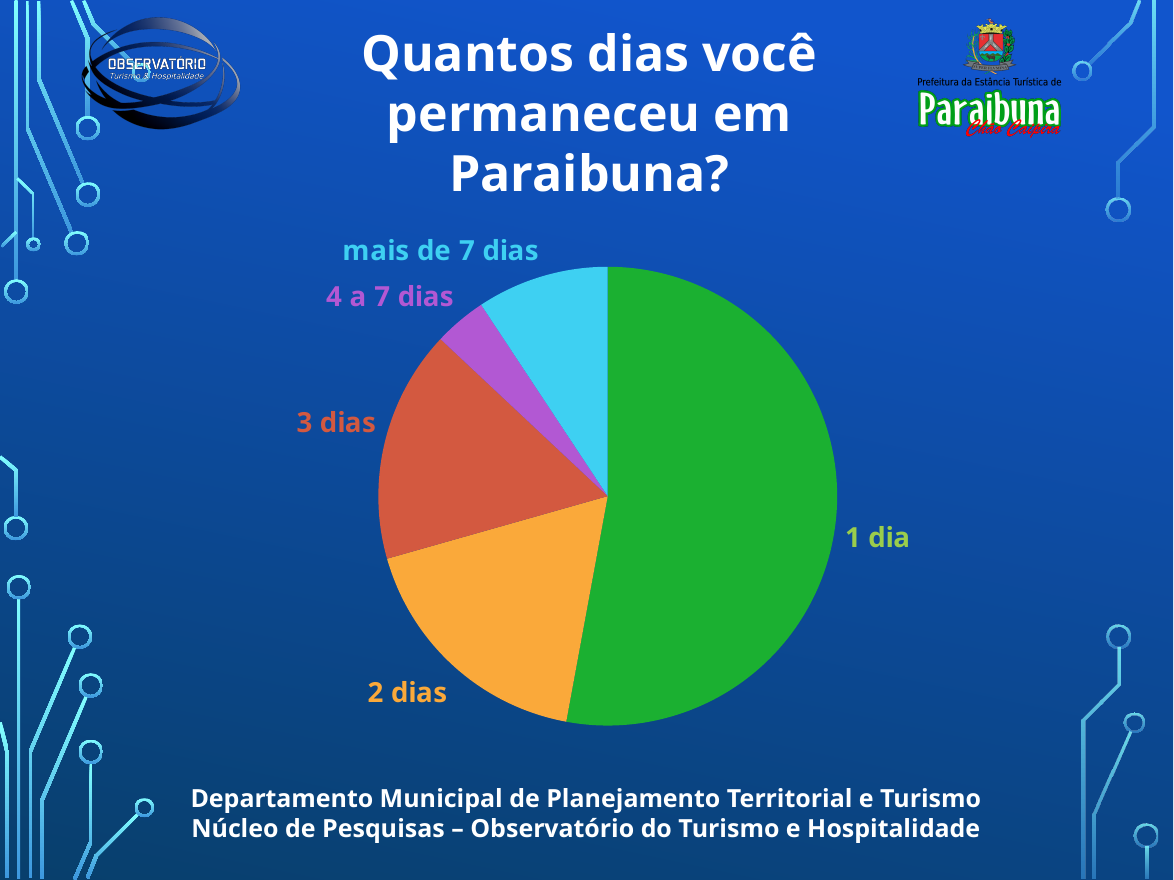
How many categories (slices) does the pie chart have? 5 Which category has the largest slice of the pie chart? 1 dia Which slice is larger, "2 dias" or "3 dias"? 2 dias What colour is the "1 dia" slice of the pie chart? green What is the title of the chart on the slide? Quantos dias você permaneceu em Paraibuna? What kind of chart is shown on the slide? pie chart Which slice is larger, "1 dia" or "2 dias"? 1 dia Which slice is larger, "mais de 7 dias" or "4 a 7 dias"? mais de 7 dias Which category has the smallest slice of the pie chart? 4 a 7 dias